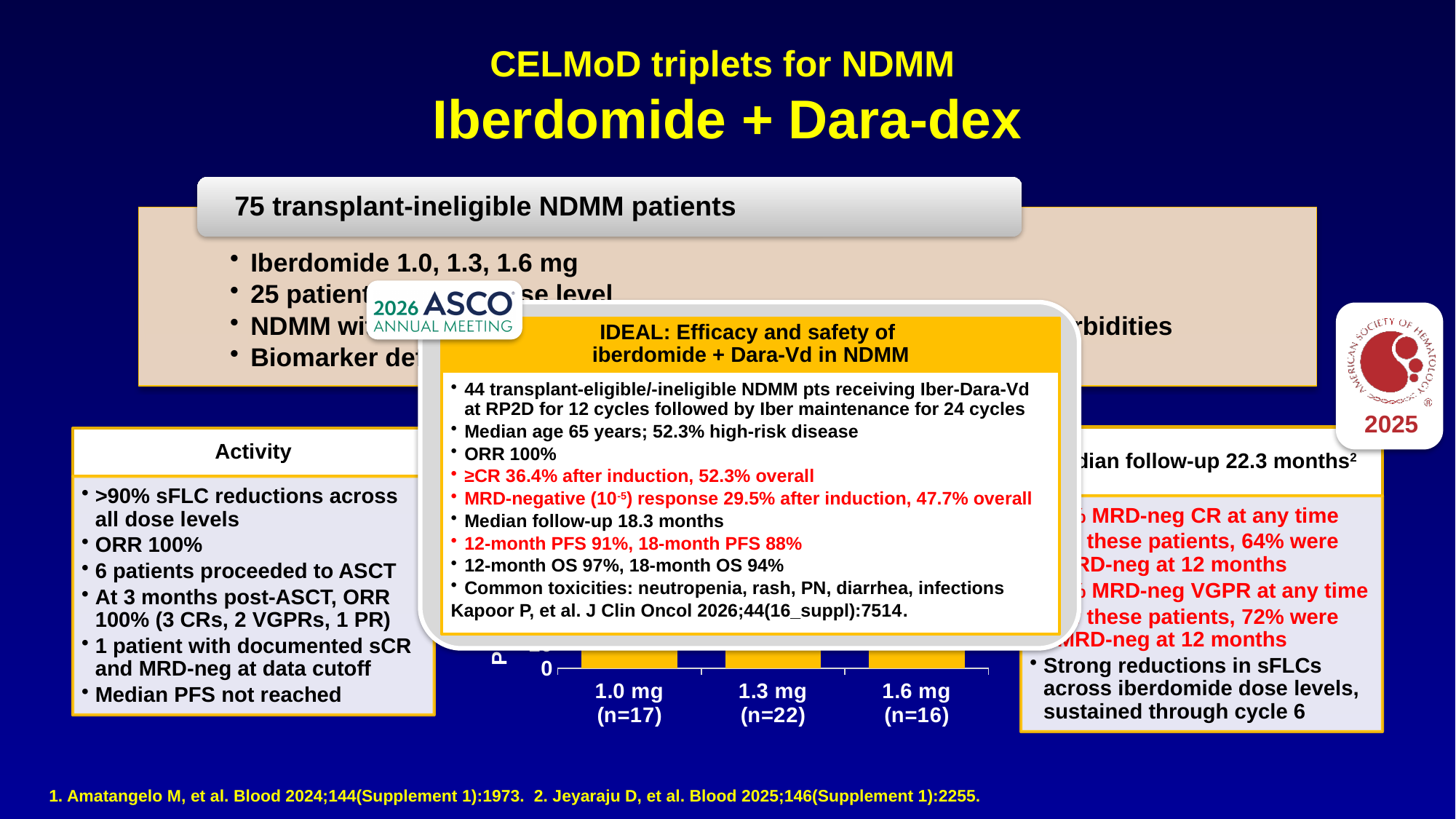
What is the label of the last category on the x axis of the bar chart? 1.6 mg (n=16) Which dose group on the x axis of the bar chart has the largest number of patients (n)? 1.3 mg (n=22) How many patients (n) are in the 1.6 mg dose group shown on the x axis of the bar chart? 16 What is the label of the first category on the x axis of the bar chart? 1.0 mg (n=17) How many patients (n) are in the 1.3 mg dose group shown on the x axis of the bar chart? 22 How many patients (n) are in the 1.0 mg dose group shown on the x axis of the bar chart? 17 What kind of chart is partially visible in the centre of the slide? bar chart Which dose group on the x axis of the bar chart has the smallest number of patients (n)? 1.6 mg (n=16) How many dose-level categories are shown on the x axis of the bar chart? 3